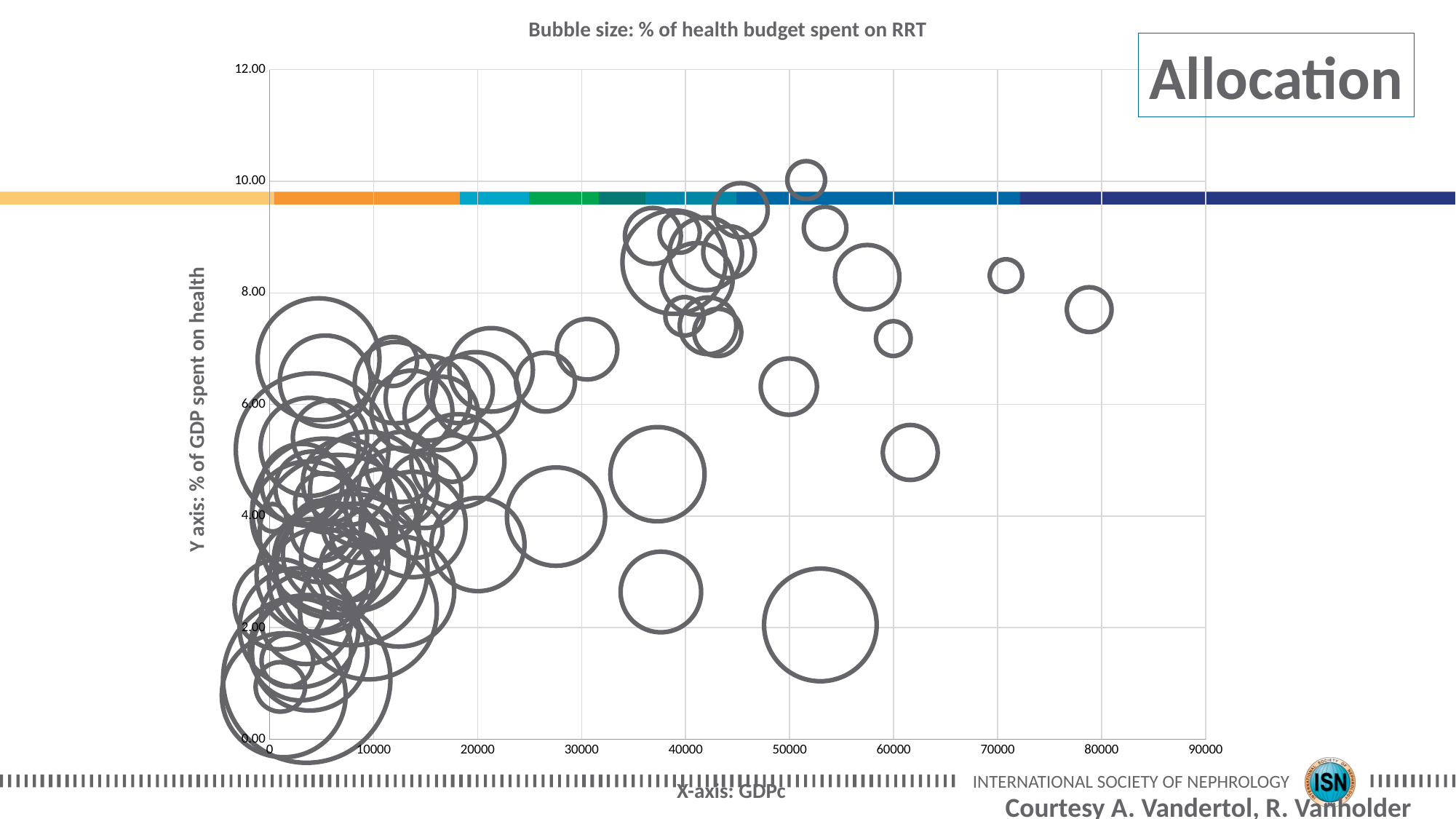
What is the label of the vertical axis of the chart? Y axis: % of GDP spent on health Is the x-axis value of the large bubble centred near 2.00 on the y axis at the right of the cluster greater or less than 50000? greater Is the y-axis value of the highest bubble on the chart greater or less than 8.00? greater Is the y-axis value of the rightmost bubble (near 80000 on the x axis) greater or less than 6.00? greater What kind of chart is shown on the slide? Bubble chart What is the title of the chart? Bubble size: % of health budget spent on RRT